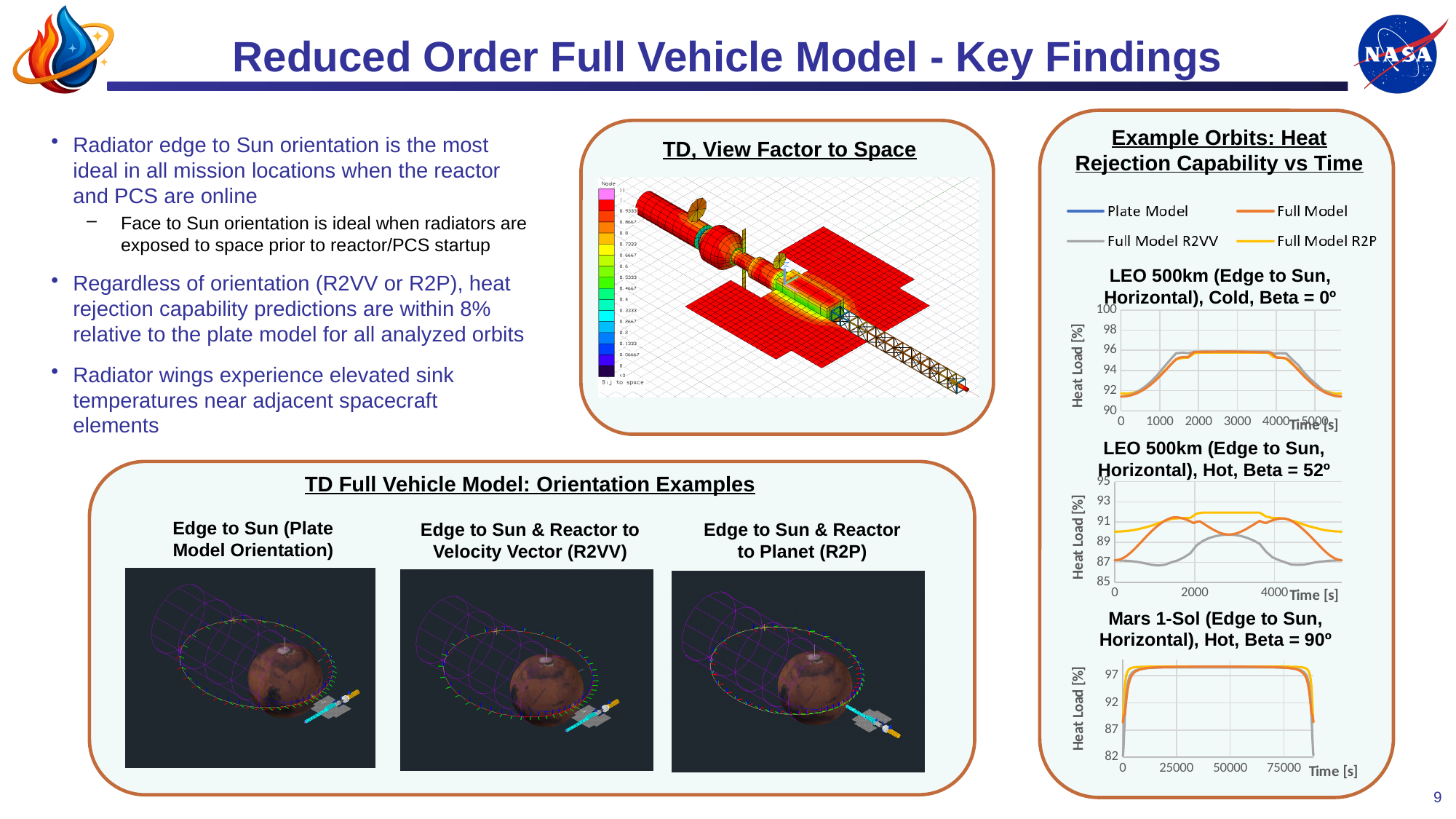
How many heat rejection capability vs time charts are shown in the 'Example Orbits' panel? 3 What kind of chart is the 'LEO 500km (Edge to Sun, Horizontal), Cold, Beta = 0º' chart? line chart In the 'LEO 500km (Edge to Sun, Horizontal), Hot, Beta = 52º' chart, is the highest Full Model R2VV value greater or less than 91? less In the 'LEO 500km (Edge to Sun, Horizontal), Hot, Beta = 52º' chart, is the Full Model R2VV value at time 0 greater or less than 89? less In the 'LEO 500km (Edge to Sun, Horizontal), Cold, Beta = 0º' chart, do the values rise or fall between time 0 and time 2000? rise In the 'Mars 1-Sol (Edge to Sun, Horizontal), Hot, Beta = 90º' chart, is the plateau heat load value greater or less than 92? greater In the 'LEO 500km (Edge to Sun, Horizontal), Hot, Beta = 52º' chart, which series has the lowest value at time 0: Full Model R2VV or Full Model R2P? Full Model R2VV In the 'LEO 500km (Edge to Sun, Horizontal), Cold, Beta = 0º' chart, what is the label of the y axis? Heat Load [%] In the 'Mars 1-Sol (Edge to Sun, Horizontal), Hot, Beta = 90º' chart, what is the largest x-axis tick label shown? 75000 How many series does the shared legend for the 'Example Orbits: Heat Rejection Capability vs Time' charts list? 4